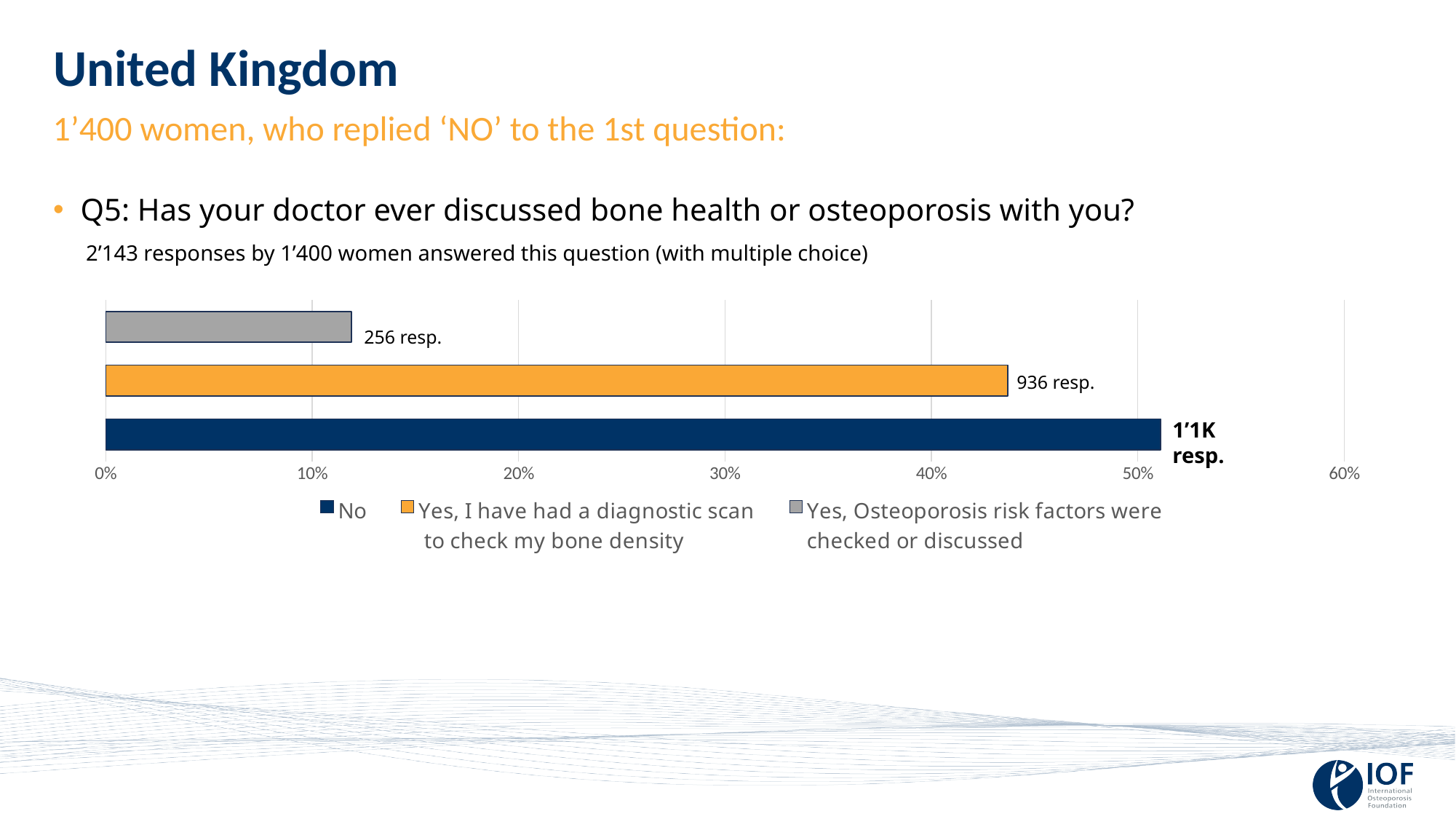
What is the data label on the bar for 'Yes, I have had a diagnostic scan to check my bone density'? 936 resp. Which received more responses: 'Yes, I have had a diagnostic scan to check my bone density' or 'Yes, Osteoporosis risk factors were checked or discussed'? Yes, I have had a diagnostic scan to check my bone density Which response option has the longest bar? No Is the percentage for 'No' greater or less than 50%? greater What colour is the bar for 'No'? dark blue What is the data label on the bar for 'No'? 1'1K resp. What is the data label on the bar for 'Yes, Osteoporosis risk factors were checked or discussed'? 256 resp. What kind of chart is shown on the slide? bar chart How many series does the legend list? 3 How many more responses did 'Yes, I have had a diagnostic scan to check my bone density' receive than 'Yes, Osteoporosis risk factors were checked or discussed'? 680 Which response option has the shortest bar? Yes, Osteoporosis risk factors were checked or discussed Is the percentage for 'Yes, I have had a diagnostic scan to check my bone density' greater or less than 40%? greater